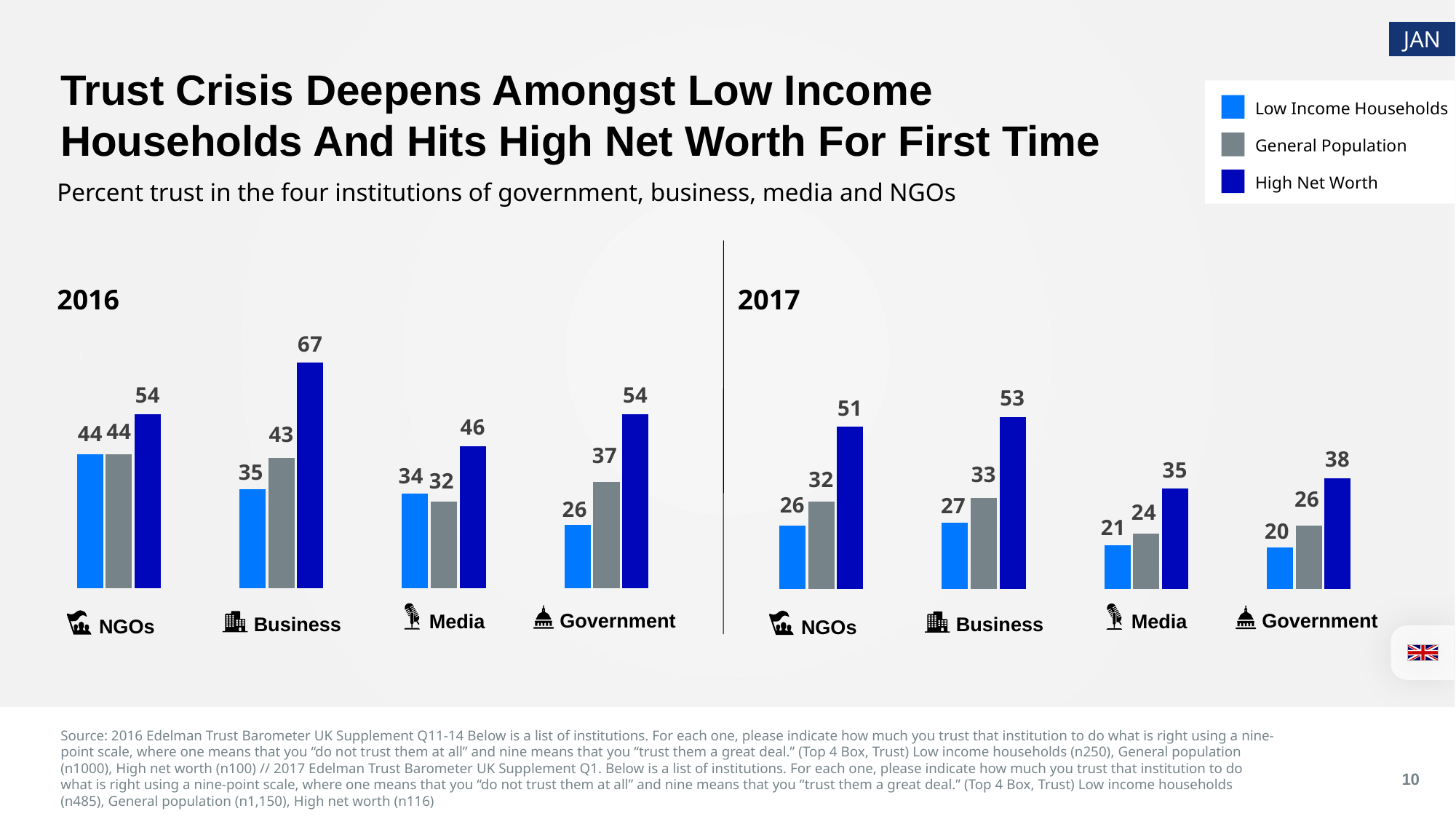
In the 2016 chart, what is the value for High Net Worth for Business? 67 In the 2017 chart, which institution has the highest High Net Worth value? Business In the 2017 chart, which institution has the lowest Low Income Households value? Government In the 2017 chart, what is the difference between the High Net Worth and General Population values for NGOs? 19 How many series does the legend list? 3 What kind of chart is the 2016 chart? Bar chart Which colour represents High Net Worth in the legend? Dark blue In the 2017 chart, what is the value for Low Income Households for Government? 20 How many institutions are shown in the 2017 chart? 4 In the 2016 chart, what is the value for General Population for Media? 32 In the 2016 chart, what is the difference between the High Net Worth and Low Income Households values for Government? 28 In the 2016 chart, which is larger for Media: Low Income Households or General Population? Low Income Households